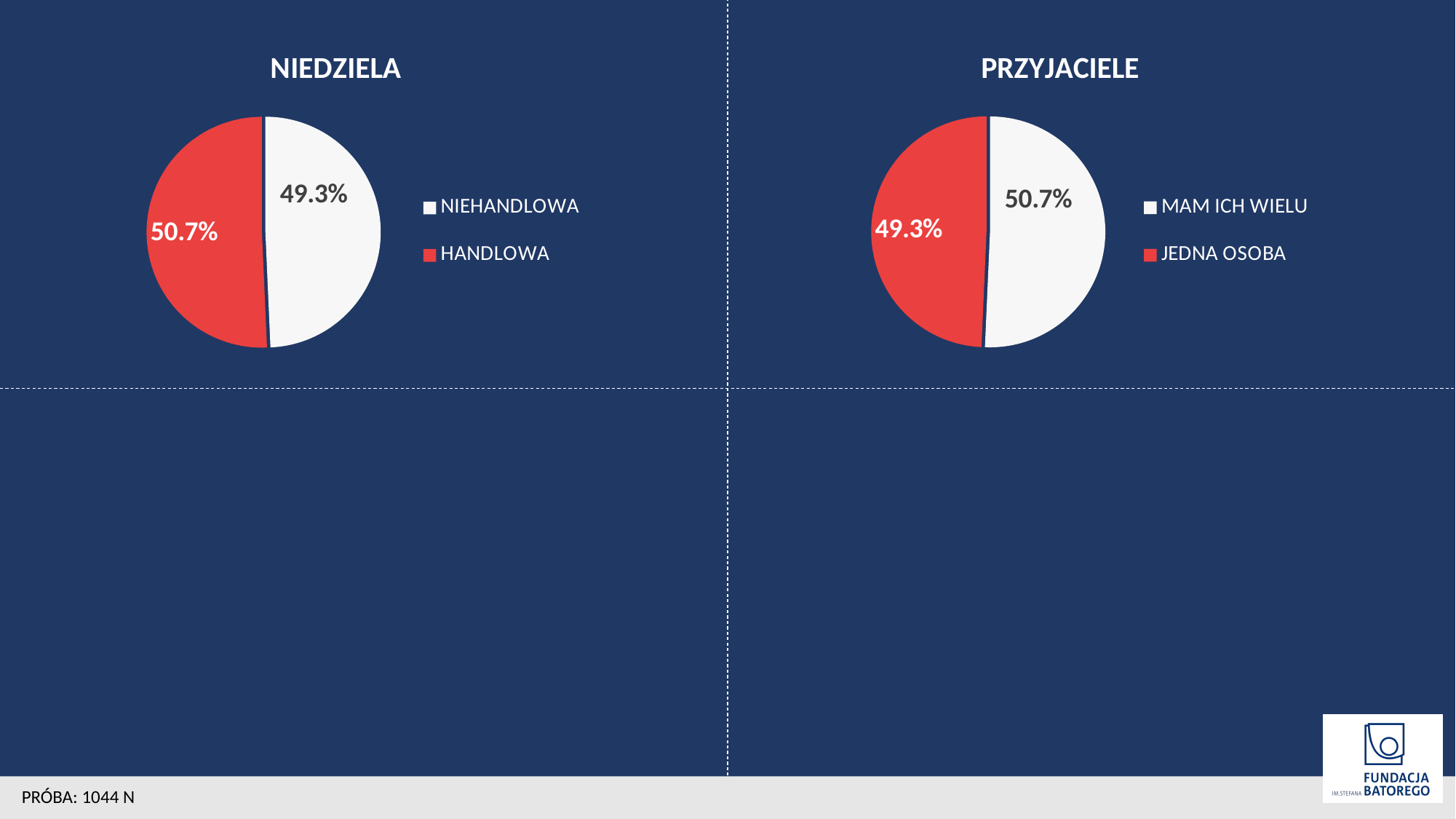
In the PRZYJACIELE chart, what share is labelled for MAM ICH WIELU? 50.7% In the PRZYJACIELE chart, what colour is the JEDNA OSOBA slice? Red How many entries does the legend of the NIEDZIELA chart list? 2 In the NIEDZIELA chart, which slice is the largest? HANDLOWA What kind of chart is the NIEDZIELA chart? Pie chart In the PRZYJACIELE chart, which is larger: MAM ICH WIELU or JEDNA OSOBA? MAM ICH WIELU In the NIEDZIELA chart, what is the difference between the HANDLOWA and NIEHANDLOWA shares? 1.4% In the NIEDZIELA chart, what share is labelled for HANDLOWA? 50.7% How many slices does the PRZYJACIELE chart have? 2 In the PRZYJACIELE chart, which slice is the smallest? JEDNA OSOBA In the PRZYJACIELE chart, what share is labelled for JEDNA OSOBA? 49.3% In the NIEDZIELA chart, what share is labelled for NIEHANDLOWA? 49.3%